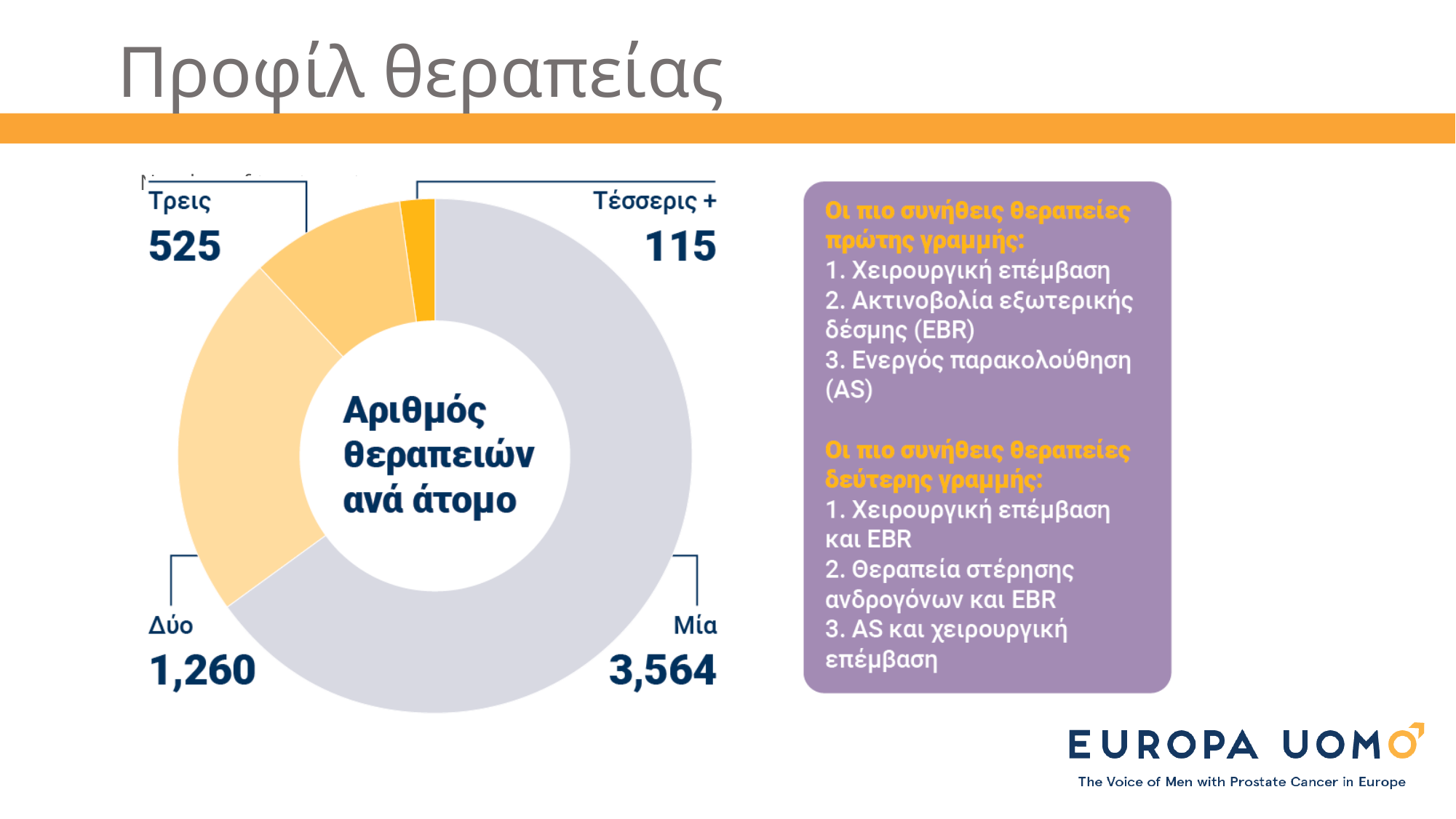
What is the difference between the values for "Τρεις" and "Τέσσερις +"? 410 What is the value for the "Δύο" category in the chart? 1,260 What is the value for the "Τρεις" category in the chart? 525 How many categories are shown in the chart? 4 What is the value for the "Τέσσερις +" category in the chart? 115 What text is written in the centre of the donut chart? Αριθμός θεραπειών ανά άτομο Which is larger, the value for "Δύο" or the value for "Τρεις"? Δύο What is the value for the "Μία" category in the chart? 3,564 Which category has the lowest value in the chart? Τέσσερις + Which category has the highest value in the chart? Μία What type of chart is shown on the slide? Donut (pie) chart What is the difference between the values for "Μία" and "Δύο"? 2,304